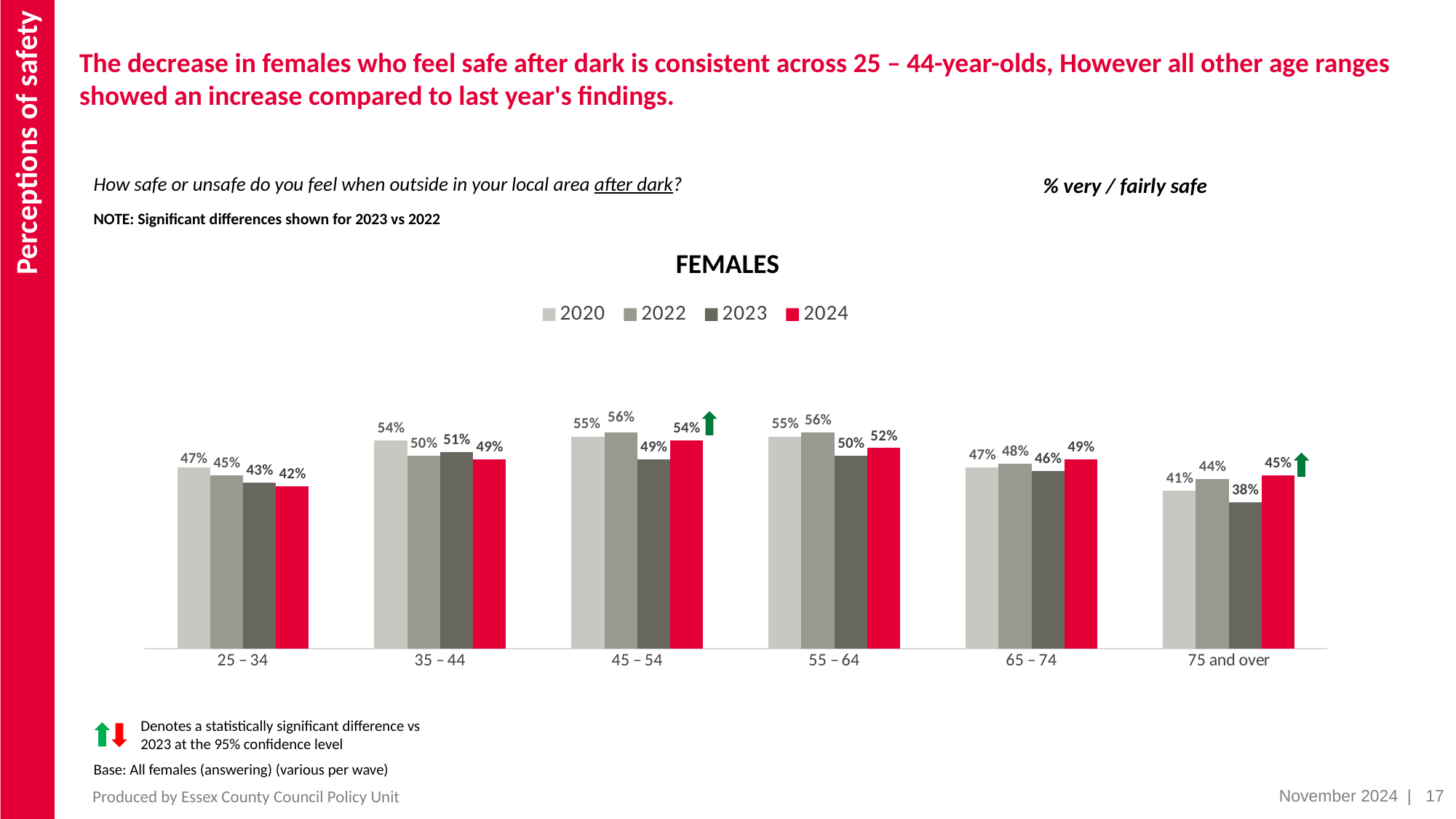
What is the difference between the 2022 and 2023 values for the 45 – 54 age group? 7% What type of chart is shown on the slide? Bar chart How many age groups are shown on the x axis? 6 Which age group has the lowest 2023 value? 75 and over Which is larger for the 25 – 34 age group, the 2020 value or the 2024 value? 2020 What is the 2024 value for the 75 and over age group? 45% What is the 2020 value for the 35 – 44 age group? 54% What is the difference between the 2023 and 2024 values for the 75 and over age group? 7% What is the 2023 value for the 45 – 54 age group? 49% Which age group has the lowest 2024 value? 25 – 34 Which age group has the highest 2024 value? 45 – 54 How many series does the legend list? 4